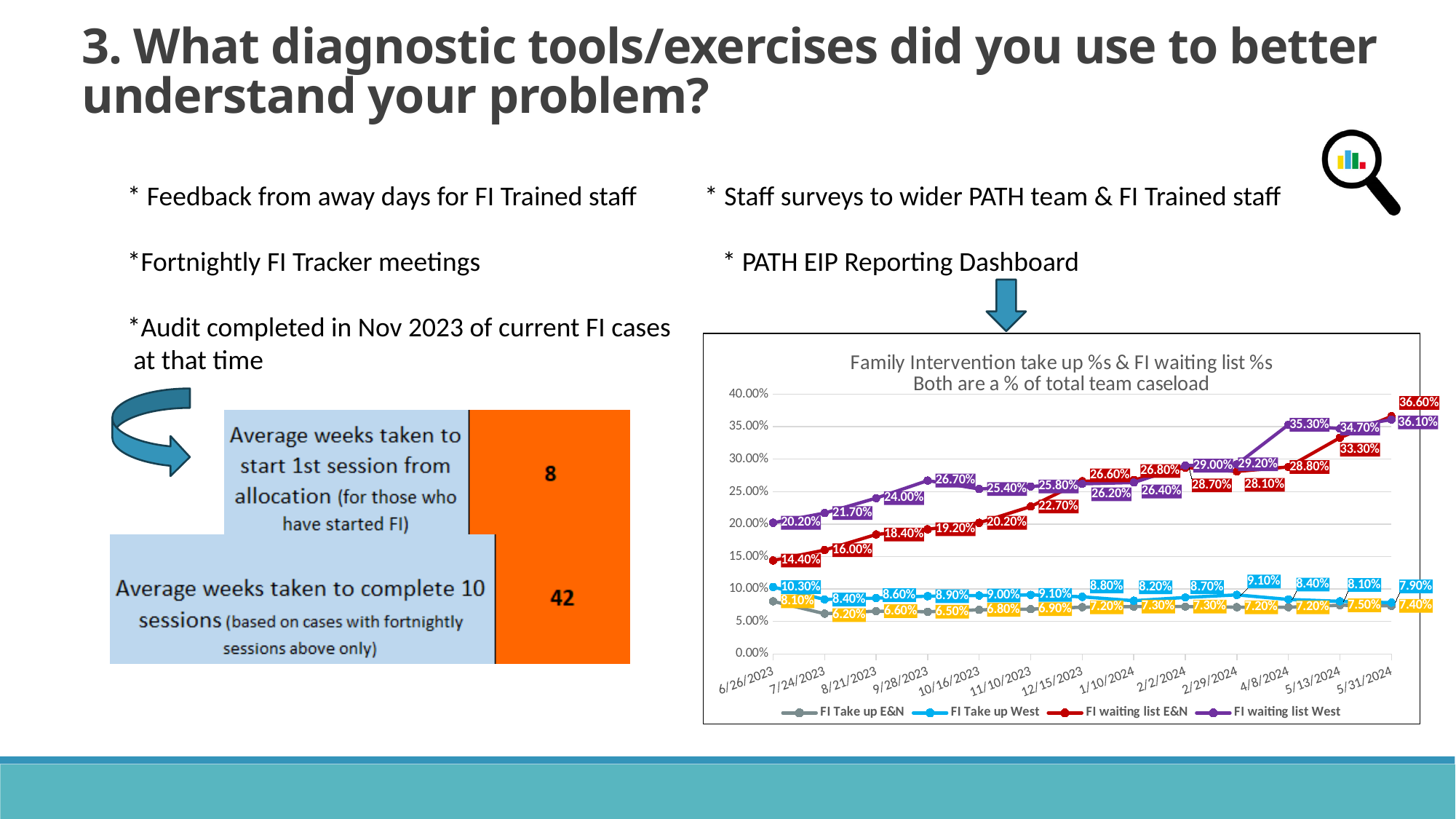
What is the title of the chart? Family Intervention take up %s & FI waiting list %s Both are a % of total team caseload What is the first plotted value of the FI waiting list E&N series? 14.40% What is the last plotted value of the FI waiting list West series? 36.10% What is the last plotted value of the FI waiting list E&N series? 36.60% At the final point, which is higher: FI waiting list E&N or FI waiting list West? FI waiting list E&N Which series has the lowest value at the first point on the x axis? FI Take up E&N What is the last plotted value of the FI Take up E&N series? 7.40% What kind of chart is shown on the slide? Line chart Does the FI waiting list E&N series generally rise or fall across the x axis? Rise How many series does the chart's legend list? 4 By how much did the FI waiting list E&N series increase from its first value to its last value? 22.20% What is the first plotted value of the FI Take up West series? 10.30%